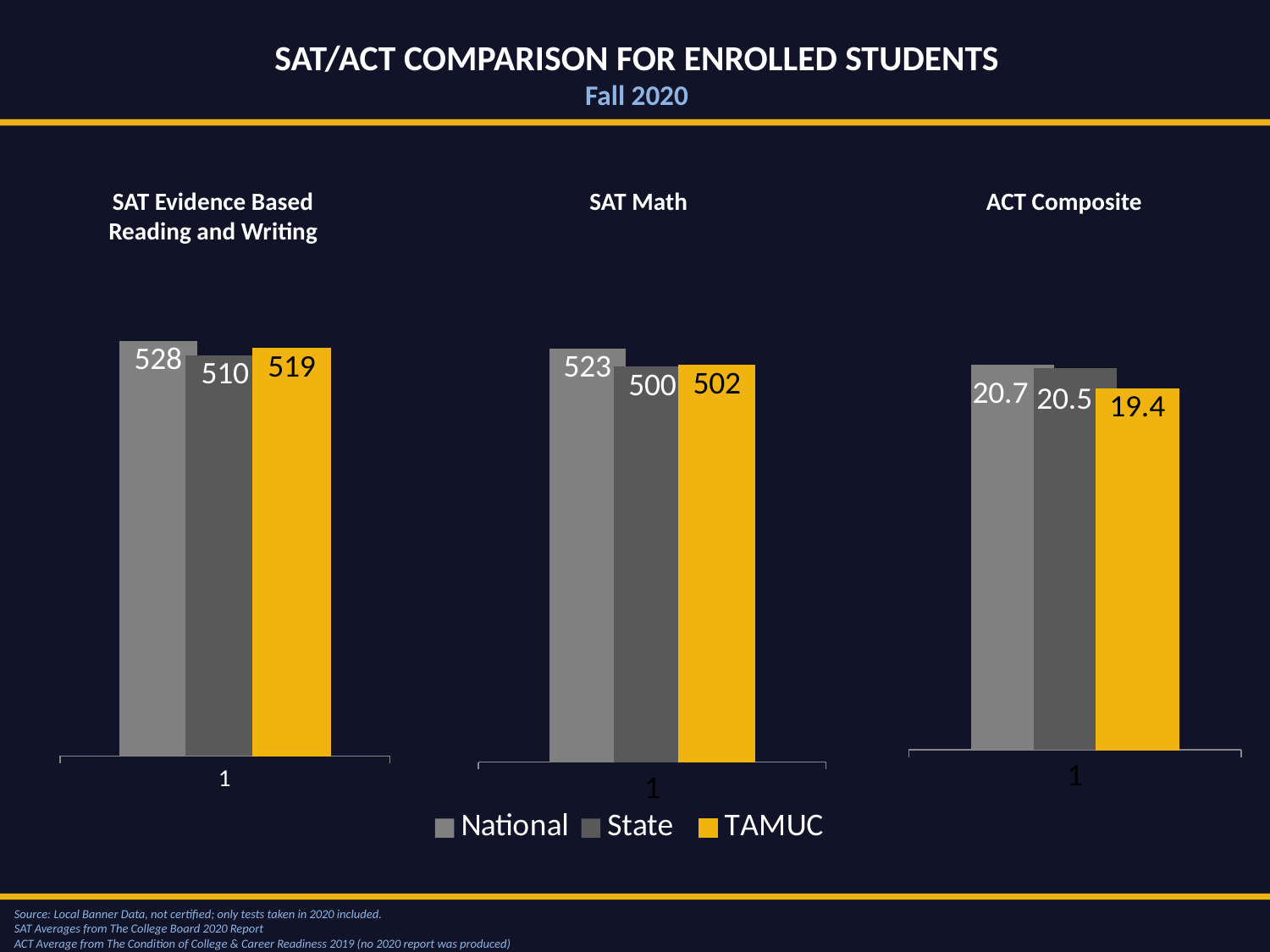
In the SAT Math chart, what is the difference between the National and State values? 23 In the SAT Evidence Based Reading and Writing chart, what is the difference between the TAMUC and State values? 9 In the ACT Composite chart, which series has the highest value? National In the SAT Math chart, what is the TAMUC value? 502 How many series does the legend list? 3 In the SAT Evidence Based Reading and Writing chart, what is the National value? 528 Which series is shown in yellow in the legend? TAMUC What kind of chart is the SAT Math chart? Bar chart In the SAT Math chart, which is larger, the State value or the TAMUC value? TAMUC In the SAT Evidence Based Reading and Writing chart, which series has the lowest value? State In the ACT Composite chart, which is larger, the National value or the TAMUC value? National In the ACT Composite chart, what is the State value? 20.5